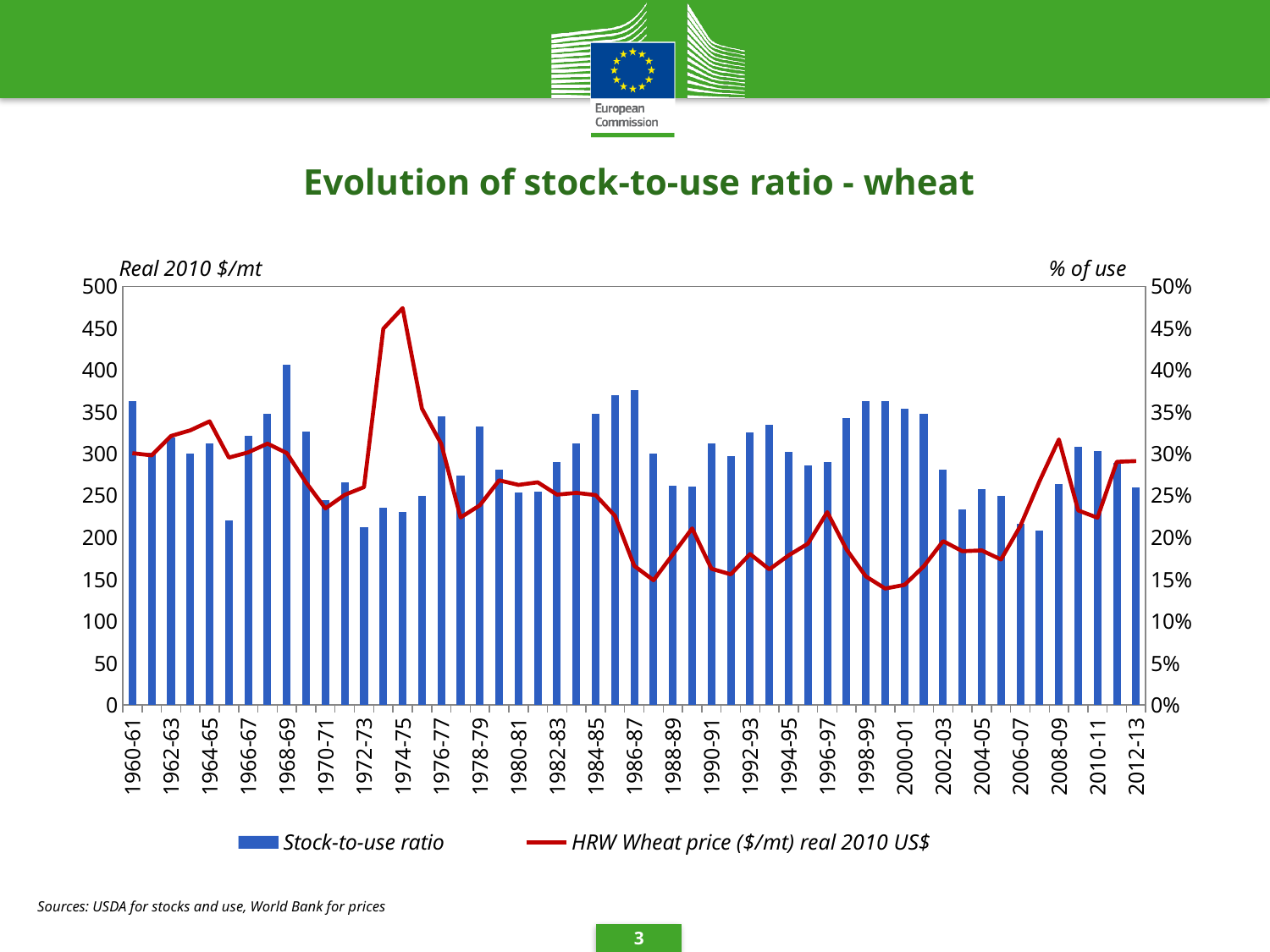
Is the HRW wheat price for 1974-75 greater or less than 450? greater Is the stock-to-use ratio for 1972-73 greater or less than 25%? less What kind of chart is used to show the stock-to-use ratio series? Bar chart Is the HRW wheat price for 1999-00 greater or less than 200? less What is the label of the left vertical axis? Real 2010 $/mt In which year does the HRW wheat price line reach its highest point? 1974-75 In which year is the stock-to-use ratio bar the highest? 1968-69 Does the HRW wheat price line rise or fall from 1974-75 to 1976-77? fall Which year has the larger stock-to-use ratio, 1968-69 or 1970-71? 1968-69 What is the title of the chart? Evolution of stock-to-use ratio - wheat How many series does the chart's legend list? 2